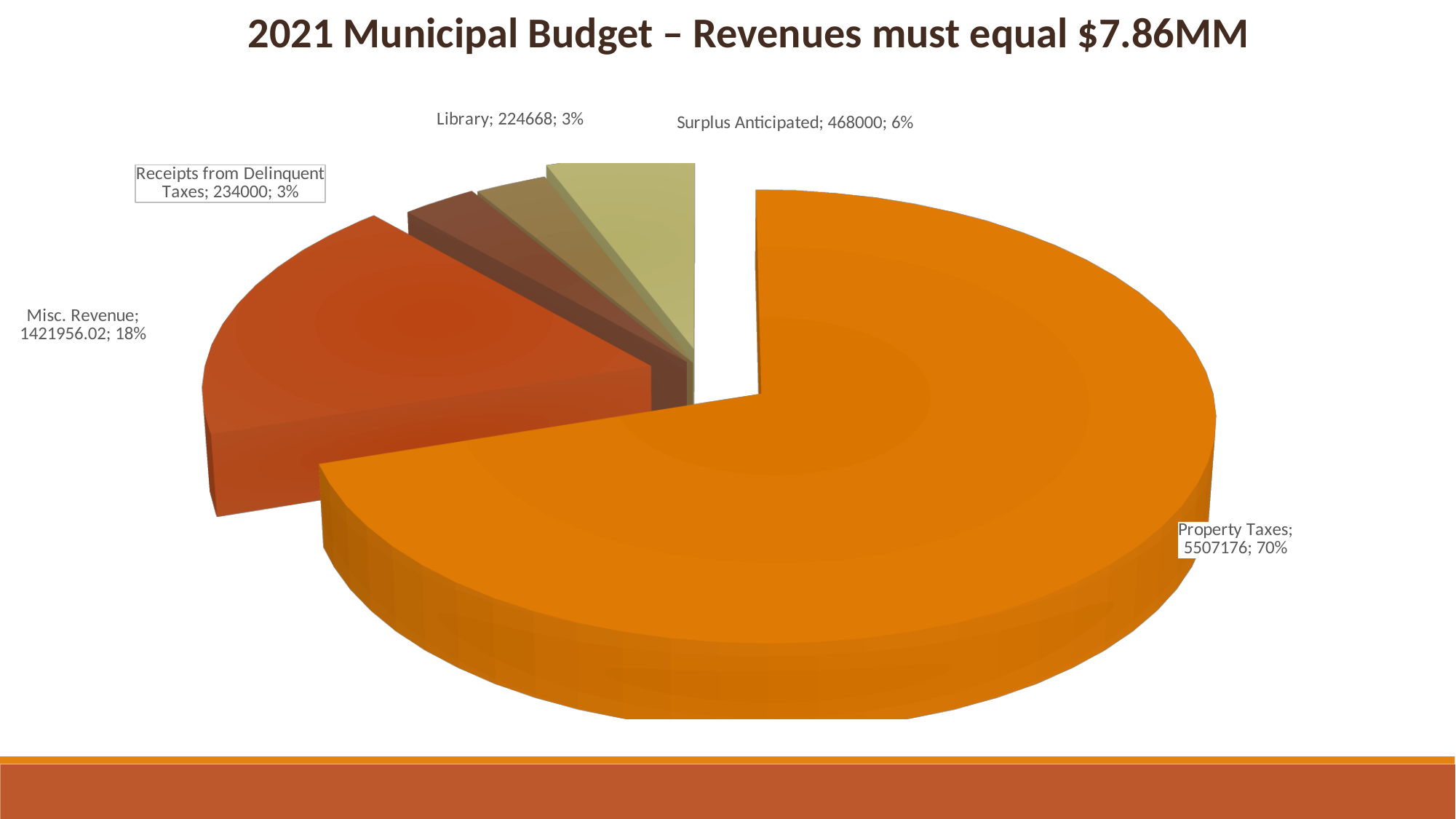
How many slices does the pie chart have? 5 What is the difference between the values for Surplus Anticipated and Receipts from Delinquent Taxes? 234000 What is the value for Misc. Revenue? 1421956.02 Which category has the smallest value? Library What share of the pie does Surplus Anticipated represent? 6% What type of chart is shown on the slide? pie chart What is the title of the chart? 2021 Municipal Budget – Revenues must equal $7.86MM Which category has the largest slice of the pie? Property Taxes What is the value for Property Taxes? 5507176 What share of the pie does Misc. Revenue represent? 18% What is the value for Library? 224668 What is the value for Surplus Anticipated? 468000